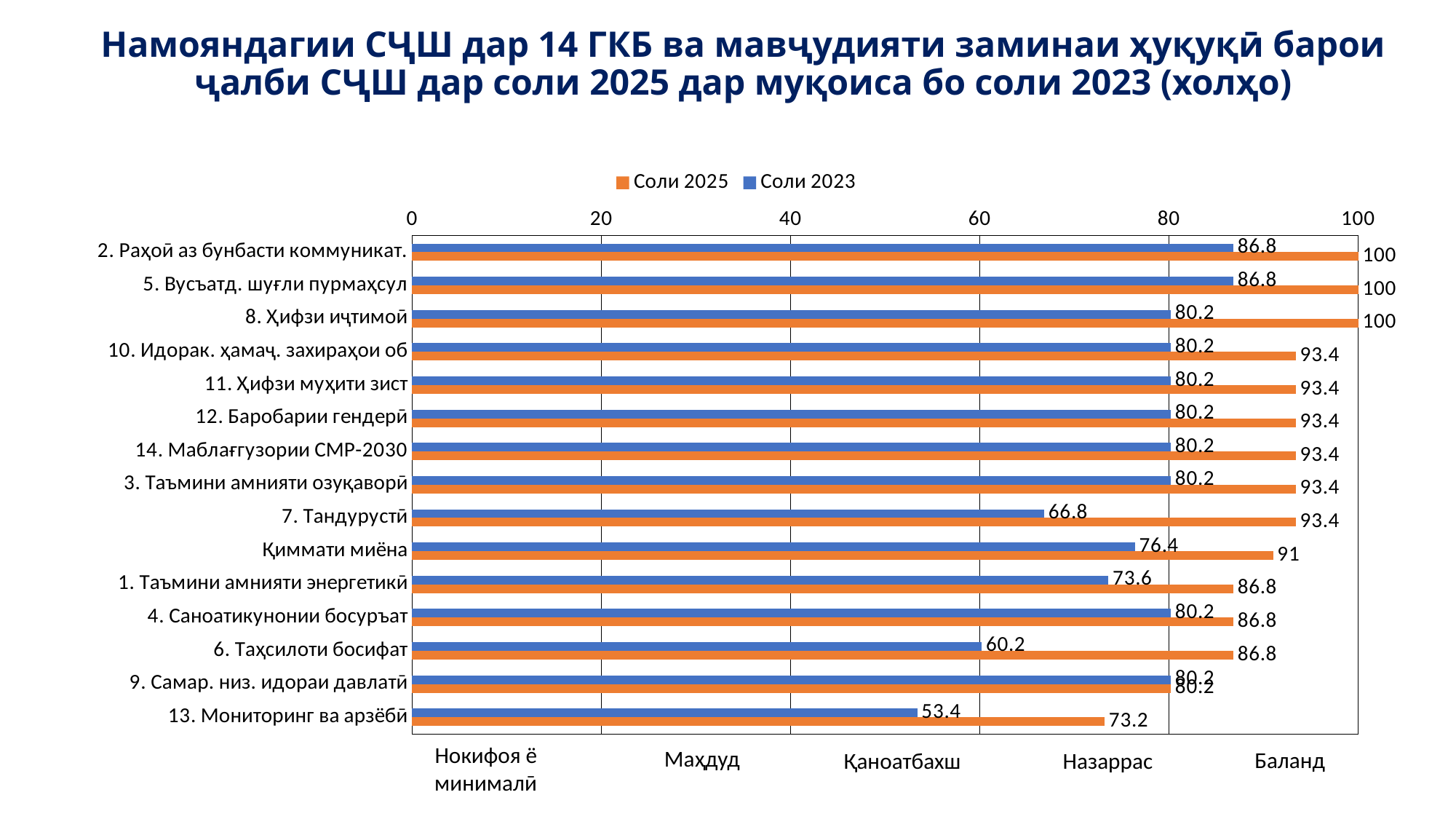
What is the value for Соли 2025 for "Қиммати миёна"? 91 What is the value for Соли 2023 for "9. Самар. низ. идораи давлатӣ"? 80.2 What is the difference between the Соли 2023 values for "2. Раҳой аз бунбасти коммуникат." and "13. Мониторинг ва арзёбӣ"? 33.4 Which category has the lowest value for Соли 2023? 13. Мониторинг ва арзёбӣ What is the difference between the Соли 2025 and Соли 2023 values for "6. Таҳсилоти босифат"? 26.6 What is the value for Соли 2023 for "7. Тандурустӣ"? 66.8 How many series does the legend list? 2 Which is larger for "1. Таъмини амнияти энергетикӣ": the Соли 2025 value or the Соли 2023 value? Соли 2025 What kind of chart is shown on the slide? bar chart Which colour represents the Соли 2023 series? blue What is the value for Соли 2025 for "13. Мониторинг ва арзёбӣ"? 73.2 How many categories are plotted on the chart? 15